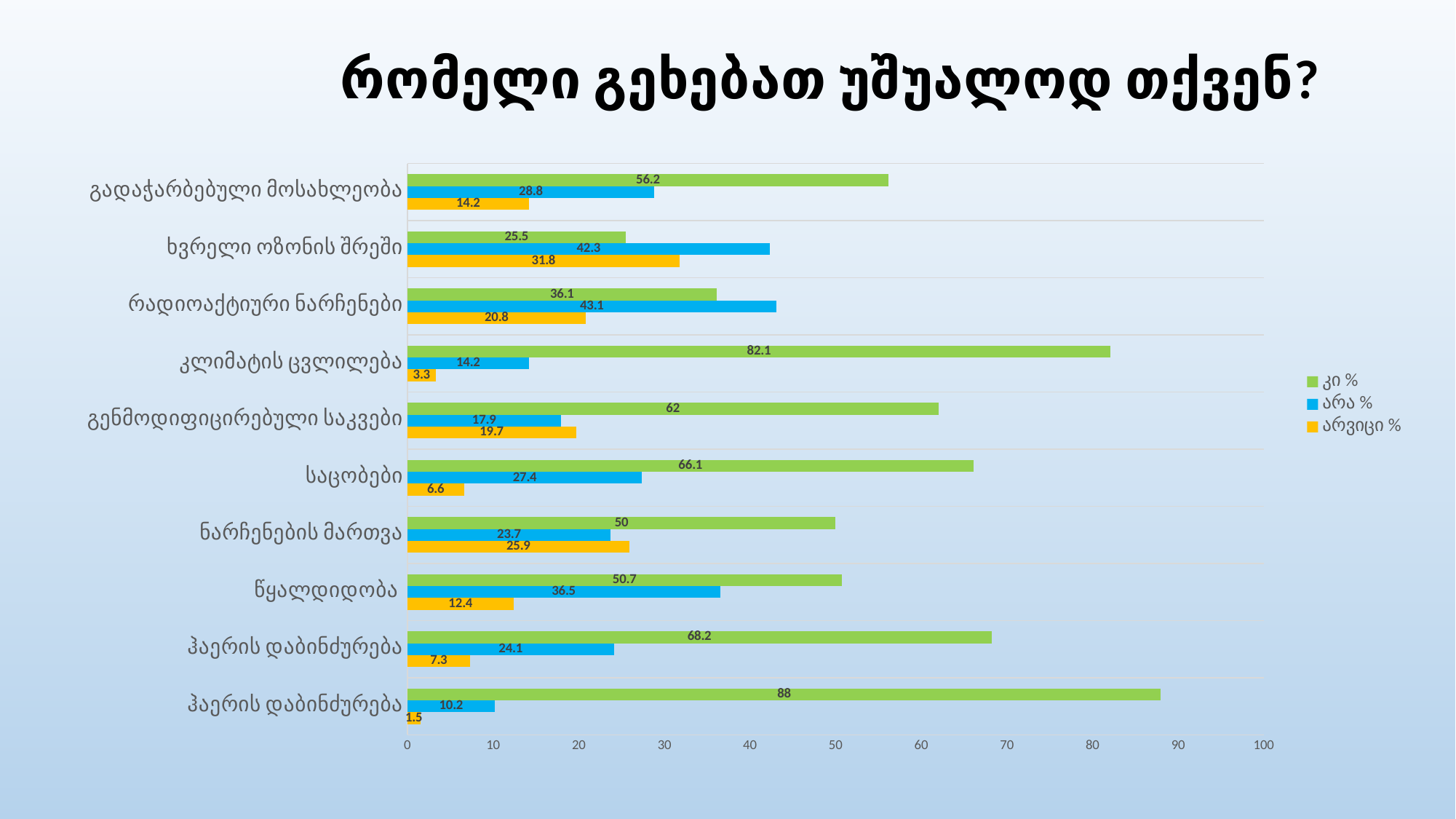
Which category has the highest არვიცი % value? ხვრელი ოზონის შრეში Is the კი % value for წყალდიდობა greater or less than 40? greater How many series does the legend list? 3 What is the კი % value for კლიმატის ცვლილება? 82.1 Which category has the lowest კი % value? ხვრელი ოზონის შრეში What is the არა % value for ხვრელი ოზონის შრეში? 42.3 What is the title of the chart? რომელი გეხებათ უშუალოდ თქვენ? What is the არვიცი % value for საცობები? 6.6 How many categories are plotted on the chart? 10 What type of chart is shown on the slide? bar chart Which is larger for ნარჩენების მართვა: the არა % value or the არვიცი % value? არვიცი % What is the difference between the კი % and არა % values for გენმოდიფიცირებული საკვები? 44.1